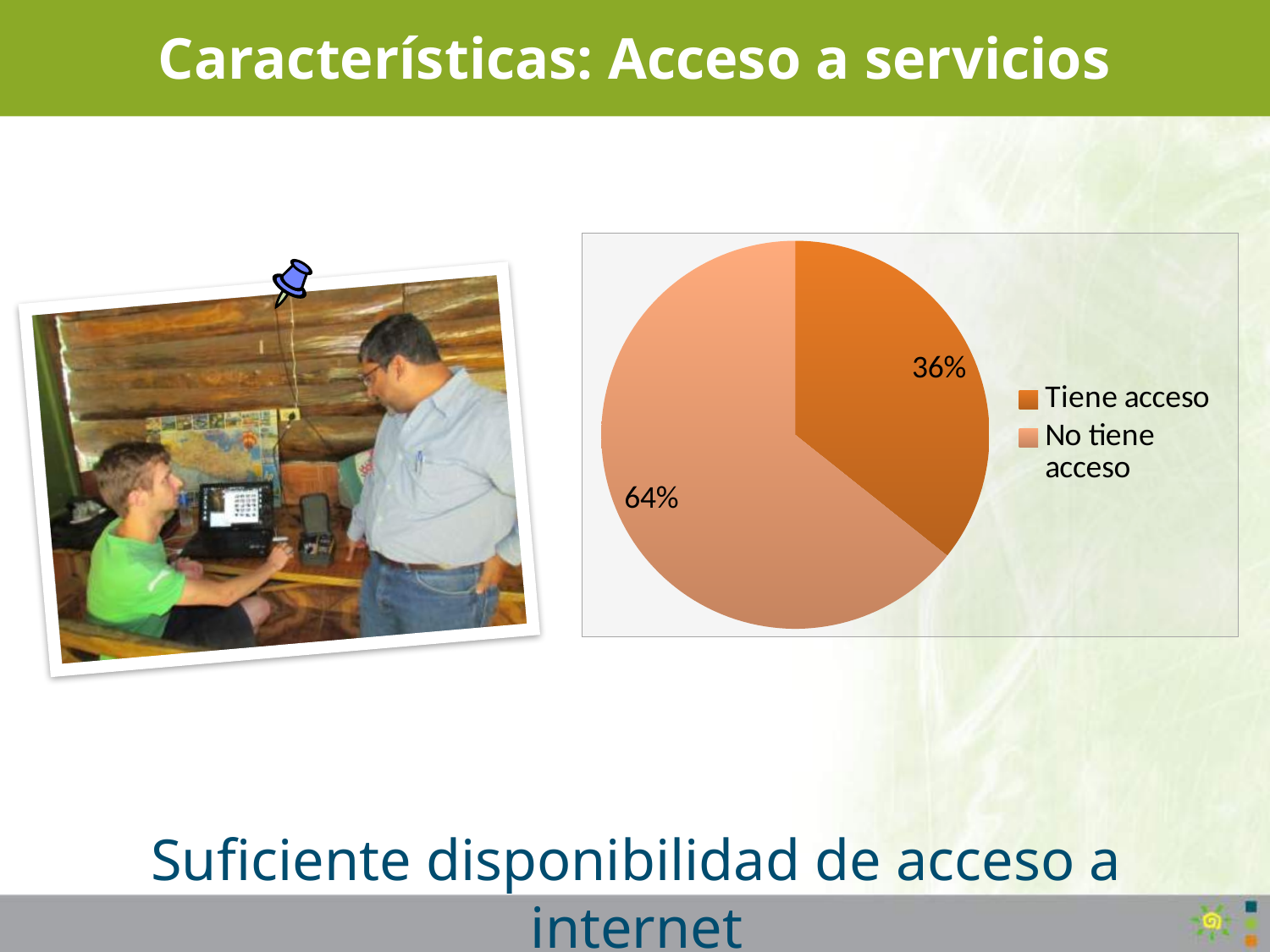
Which slice of the pie is the smallest? Tiene acceso Which slice of the pie is the largest? No tiene acceso Which is larger, the "Tiene acceso" slice or the "No tiene acceso" slice? No tiene acceso How many entries does the legend list? 2 What percentage of the pie is labelled "No tiene acceso"? 64% What kind of chart is shown on the slide? pie chart Which legend entry is shown in the darker orange colour? Tiene acceso What share of the pie does the "Tiene acceso" slice represent? 36% What is the difference in percentage points between the "No tiene acceso" and "Tiene acceso" slices? 28 What is the title of the slide containing the pie chart? Características: Acceso a servicios What percentage of the pie is labelled "Tiene acceso"? 36% How many slices does the pie chart have? 2